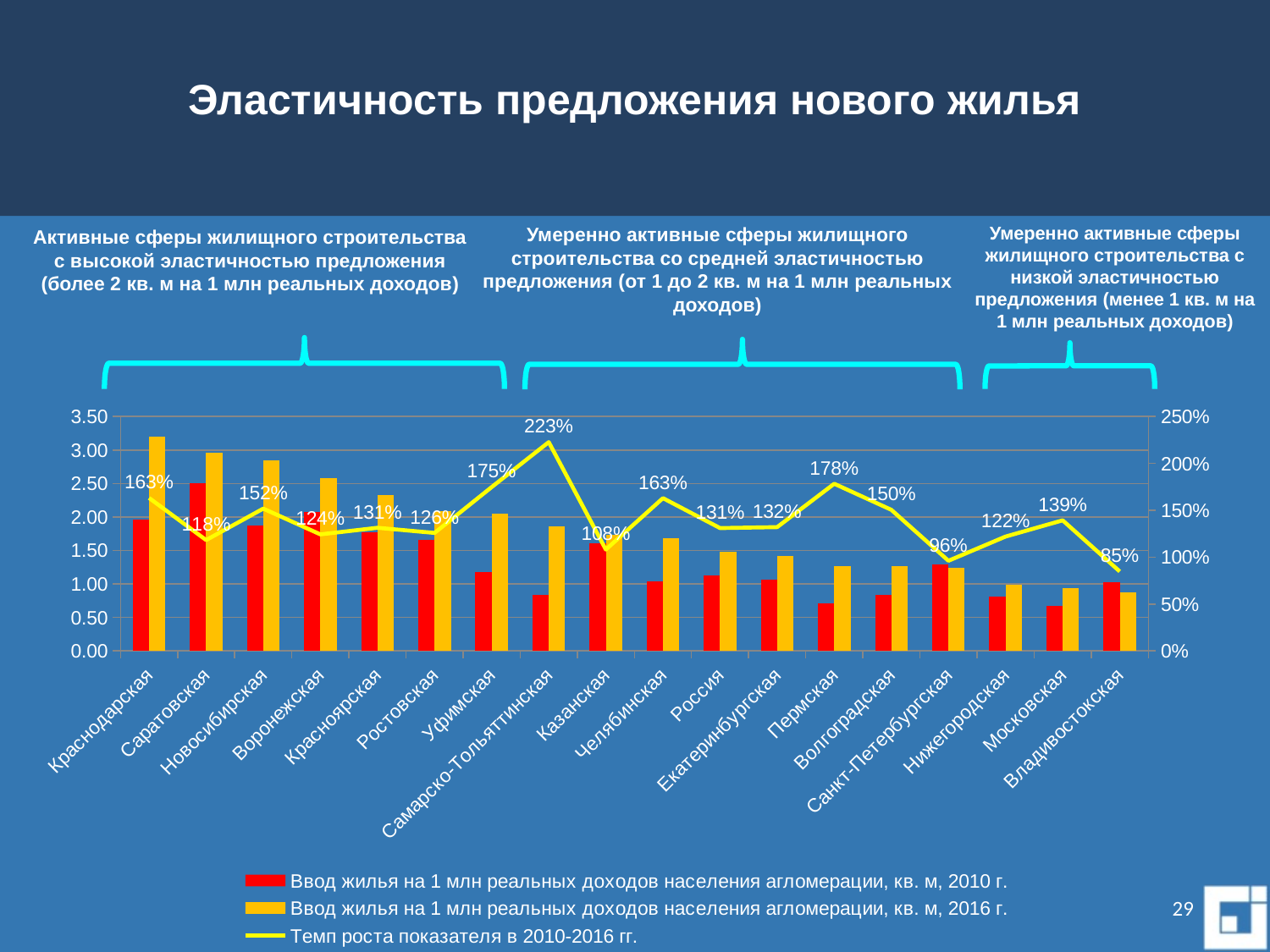
What is the difference between the highest and lowest growth rate values on the line? 138% Which category has the highest growth rate on the line series? Самарско-Тольяттинская What kind of chart is shown on the slide? Bar chart with a line Which has a higher growth rate, Пермская or Волгоградская? Пермская How many series does the legend list? 3 How many categories are shown on the x axis? 18 Which category has the lowest growth rate on the line series? Владивостокская Is the 2016 value (orange bar) for Краснодарская greater or less than 3.00? greater Is the 2010 value (red bar) for Самарско-Тольяттинская greater or less than 1.00? less What is the growth rate (Темп роста показателя в 2010-2016 гг.) shown for Самарско-Тольяттинская? 223% What is the growth rate value labelled for Владивостокская? 85% What is the growth rate value labelled for Пермская? 178%